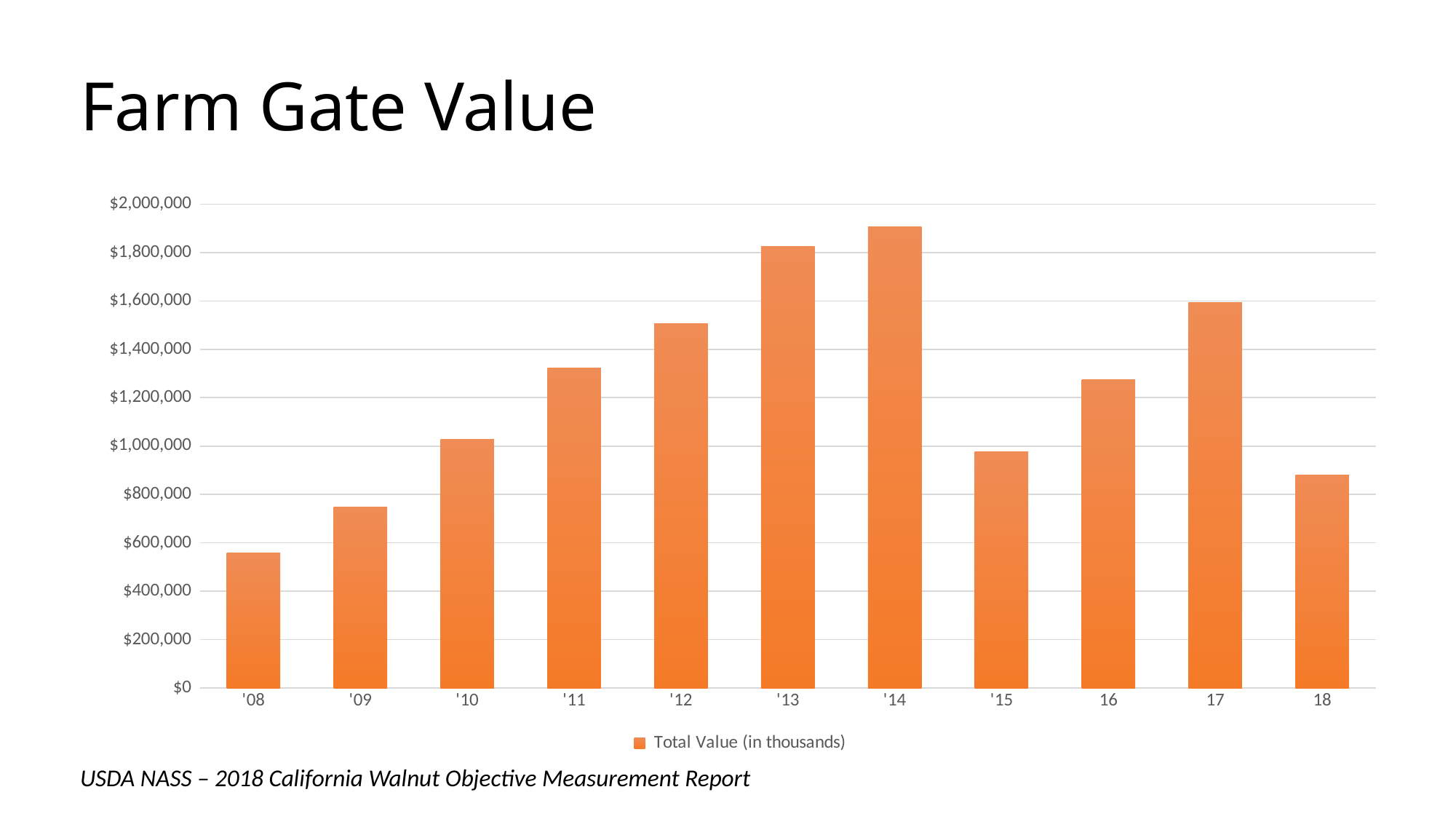
Is the Total Value for '15 greater or less than $1,000,000? less What is the legend entry for the series shown? Total Value (in thousands) Which year has the lowest Total Value? '08 Do the values rise or fall from '08 to '14? rise Is the Total Value for '08 greater or less than $600,000? less Which year has the highest Total Value? '14 Is the Total Value for 17 greater or less than $1,400,000? greater Which year has the larger Total Value, '13 or 17? '13 How many series does the legend list? 1 How many years are plotted on the chart? 11 What kind of chart is shown on the slide? bar chart